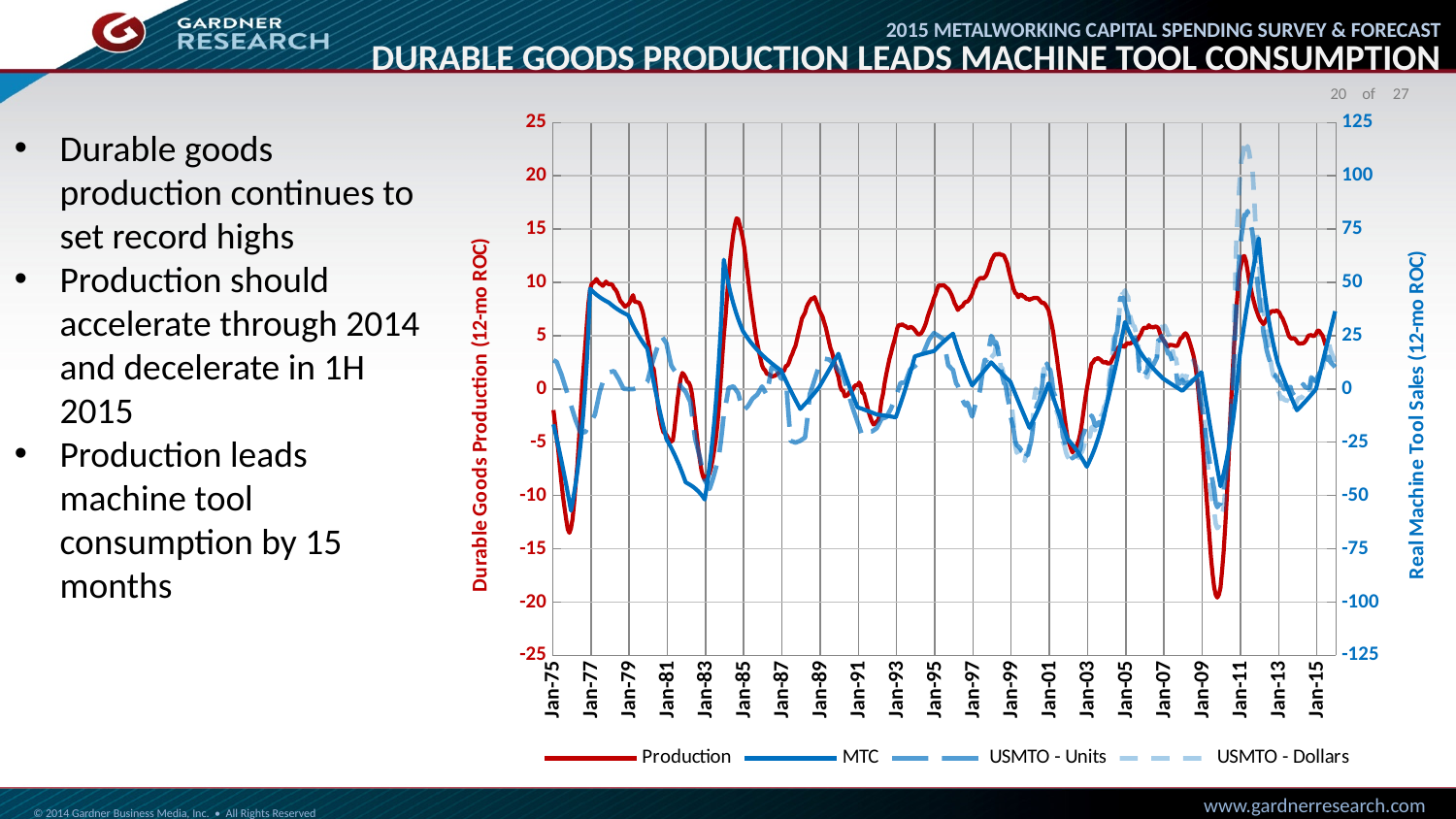
What are the four series named in the chart legend? Production, MTC, USMTO - Units, USMTO - Dollars What is the highest value shown on the right vertical axis of the chart? 125 What is the lowest value shown on the left vertical axis of the chart? -25 What is the title of the left vertical axis of the chart? Durable Goods Production (12-mo ROC) How many series does the chart legend list? 4 How many date labels are shown on the x axis of the chart? 21 What kind of chart is shown on the slide? line chart What is the first date label on the x axis of the chart? Jan-75 What is the last date label on the x axis of the chart? Jan-15